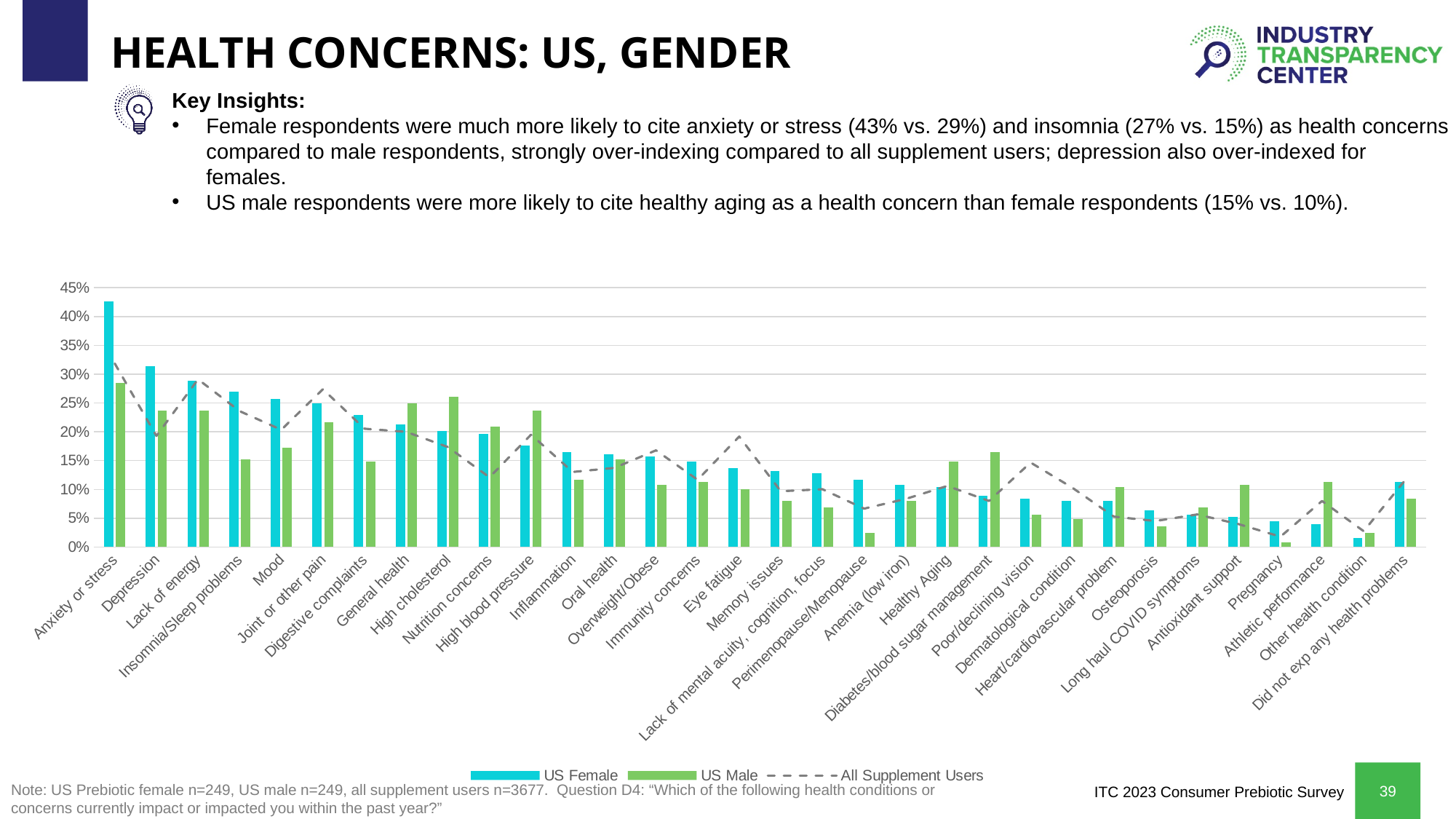
How many series does the legend list? 3 For High cholesterol, which is larger: the US Female value or the US Male value? US Male Do the US Female values generally rise or fall moving from left to right along the x axis? fall Which health concern has the highest value for US Male? Anxiety or stress Is the US Male value for Insomnia/Sleep problems greater or less than 20%? less Is the US Male value for Perimenopause/Menopause greater or less than 5%? less For Healthy Aging, which is larger: the US Female value or the US Male value? US Male Which health concern has the lowest value for US Male? Pregnancy What kind of chart is shown on the slide? combination bar and line chart How many health concern categories are shown on the x axis? 32 Which health concern has the highest value for US Female? Anxiety or stress Is the US Female value for Anxiety or stress greater or less than 40%? greater